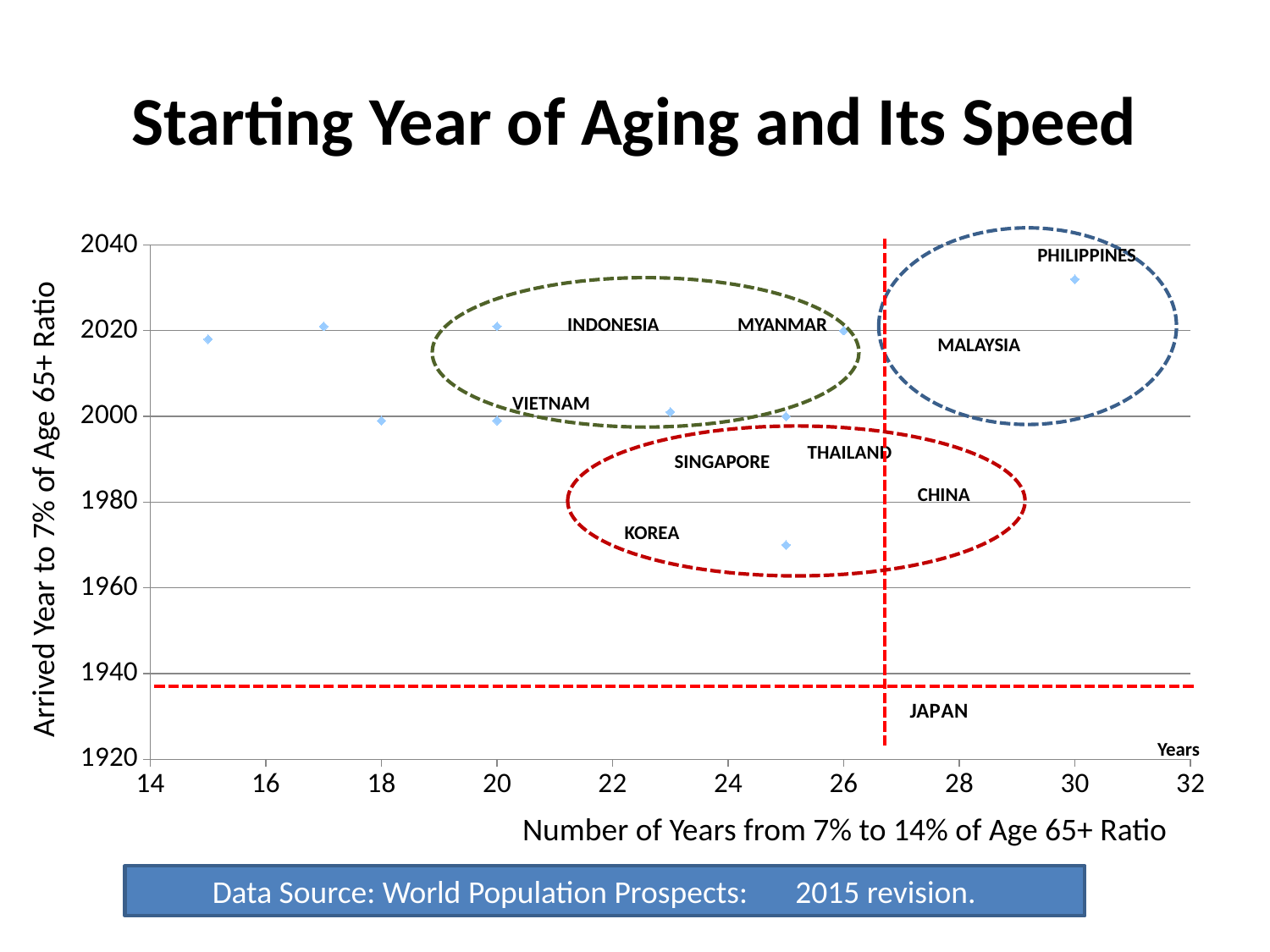
Is the y value of the point plotted at x = 30 greater or less than 2020? greater What kind of chart is shown on the slide? scatter chart Is the y value of the lowest plotted point greater or less than 1980? less What is the highest value shown on the y axis? 2040 How many data points are plotted on the chart? 10 What is the title of the chart? Starting Year of Aging and Its Speed What is the label of the x axis? Number of Years from 7% to 14% of Age 65+ Ratio Is the y value of the point plotted at x = 18 greater or less than 2020? less What is the x value of the rightmost plotted point? 30 Which has the larger y value: the point at x = 30 or the point at x = 26? the point at x = 30